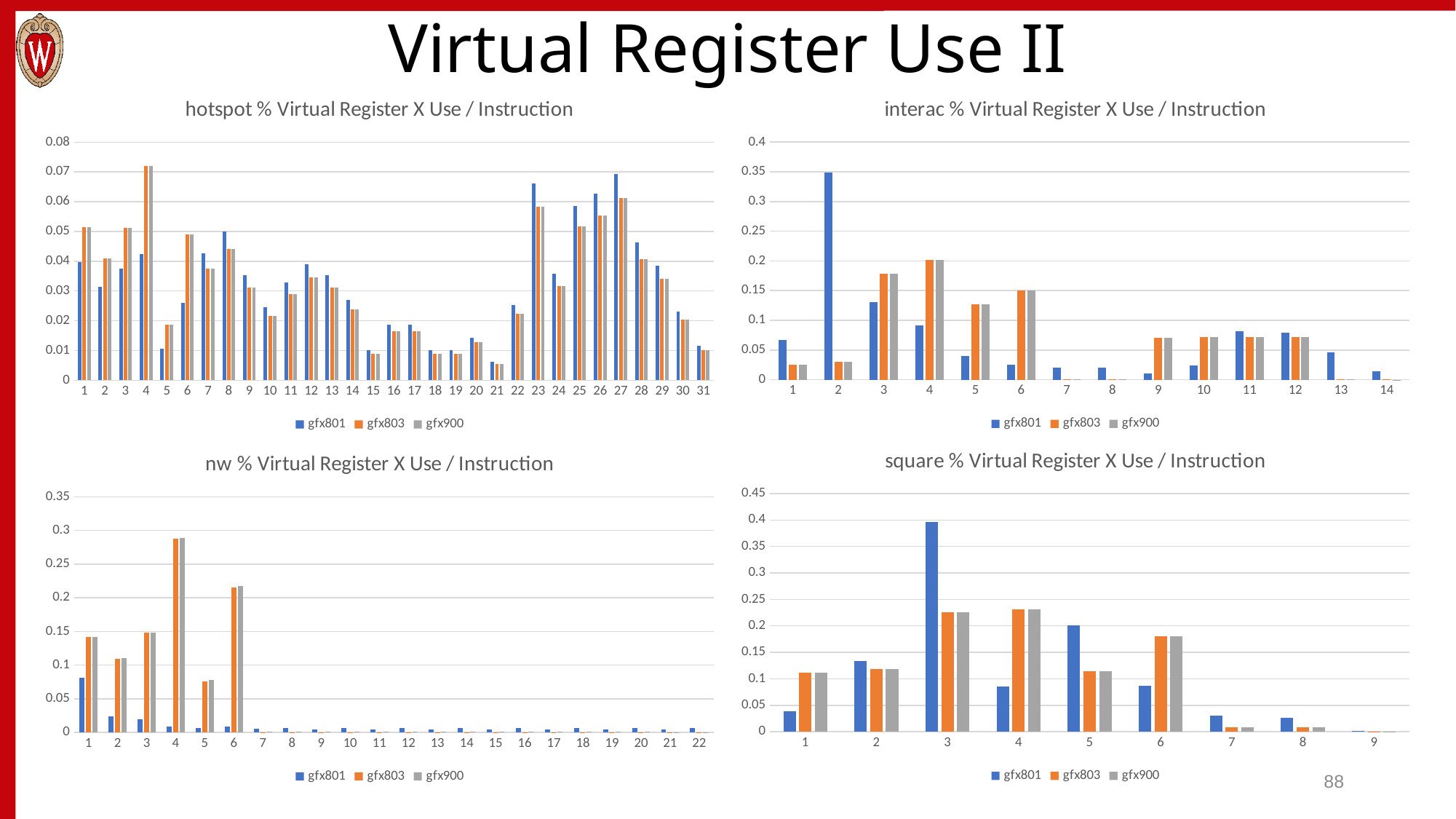
In the 'hotspot % Virtual Register X Use / Instruction' chart, which is larger for category 4: gfx801 or gfx803? gfx803 How many categories are shown on the x axis of the 'interac % Virtual Register X Use / Instruction' chart? 14 How many categories are shown on the x axis of the 'square % Virtual Register X Use / Instruction' chart? 9 In the 'interac % Virtual Register X Use / Instruction' chart, is the gfx801 value for category 2 greater or less than 0.3? greater In the 'interac % Virtual Register X Use / Instruction' chart, which category has the highest gfx801 value? 2 In the 'square % Virtual Register X Use / Instruction' chart, which category has the highest gfx801 value? 3 What kind of chart is the 'hotspot % Virtual Register X Use / Instruction' chart? bar chart What are the legend entries of the 'nw % Virtual Register X Use / Instruction' chart? gfx801, gfx803, gfx900 In the 'nw % Virtual Register X Use / Instruction' chart, which category has the highest gfx803 value? 4 How many series does the legend of the 'square % Virtual Register X Use / Instruction' chart list? 3 How many categories are shown on the x axis of the 'hotspot % Virtual Register X Use / Instruction' chart? 31